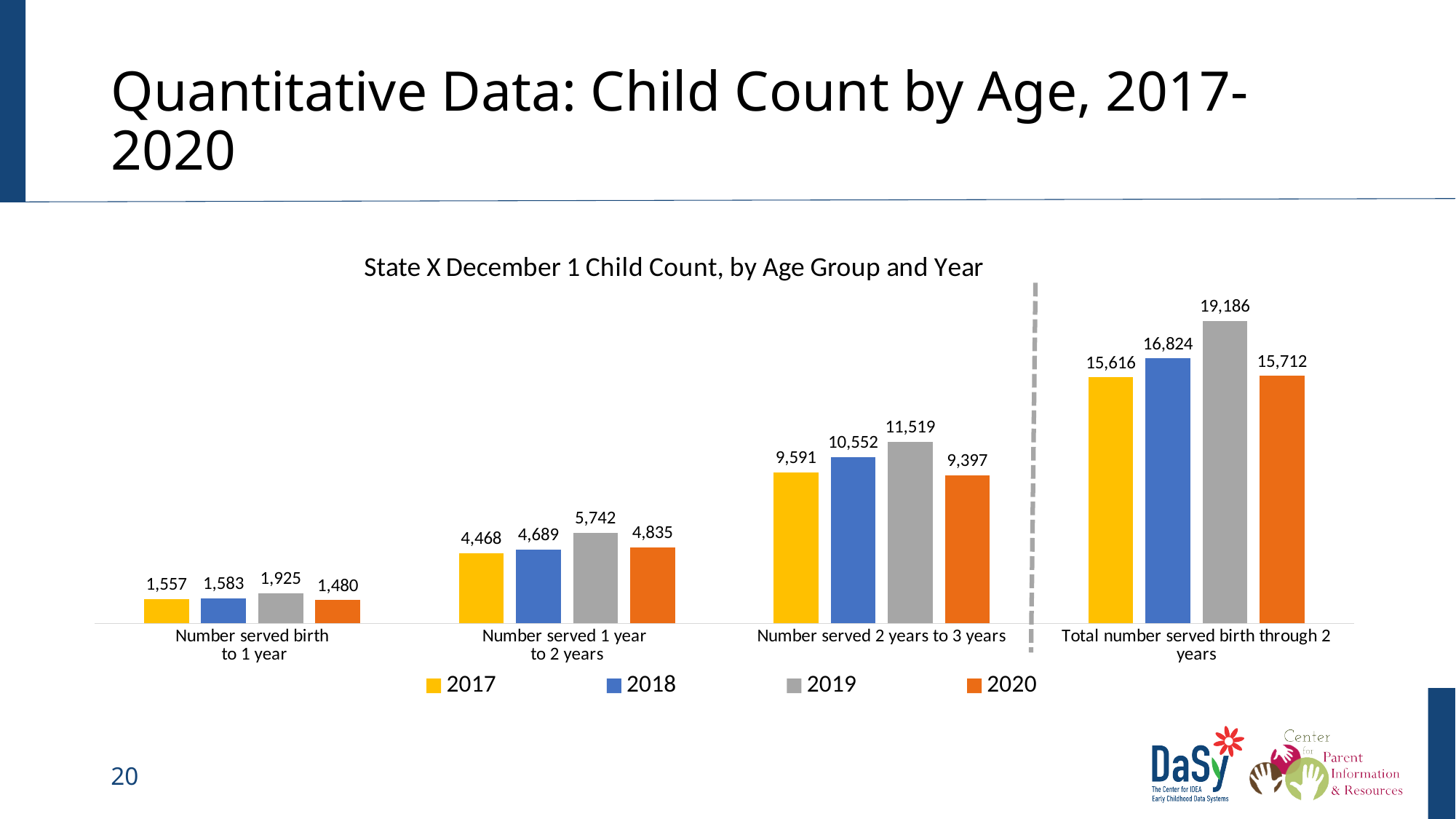
What is the difference between the 2019 and 2020 values for number served 2 years to 3 years? 2,122 Which is larger: the 2017 or the 2020 value for number served 1 year to 2 years? 2020 What is the title of the chart? State X December 1 Child Count, by Age Group and Year What kind of chart is shown on the slide? Bar chart Which year has the lowest total number served birth through 2 years? 2017 What is the number served birth to 1 year in 2019? 1,925 Which colour represents 2019 in the legend? Gray What is the total number served birth through 2 years in 2018? 16,824 Which year has the highest number served 1 year to 2 years? 2019 What is the number served 2 years to 3 years in 2020? 9,397 How many age-group categories are shown on the x axis? 4 How many series does the legend list? 4